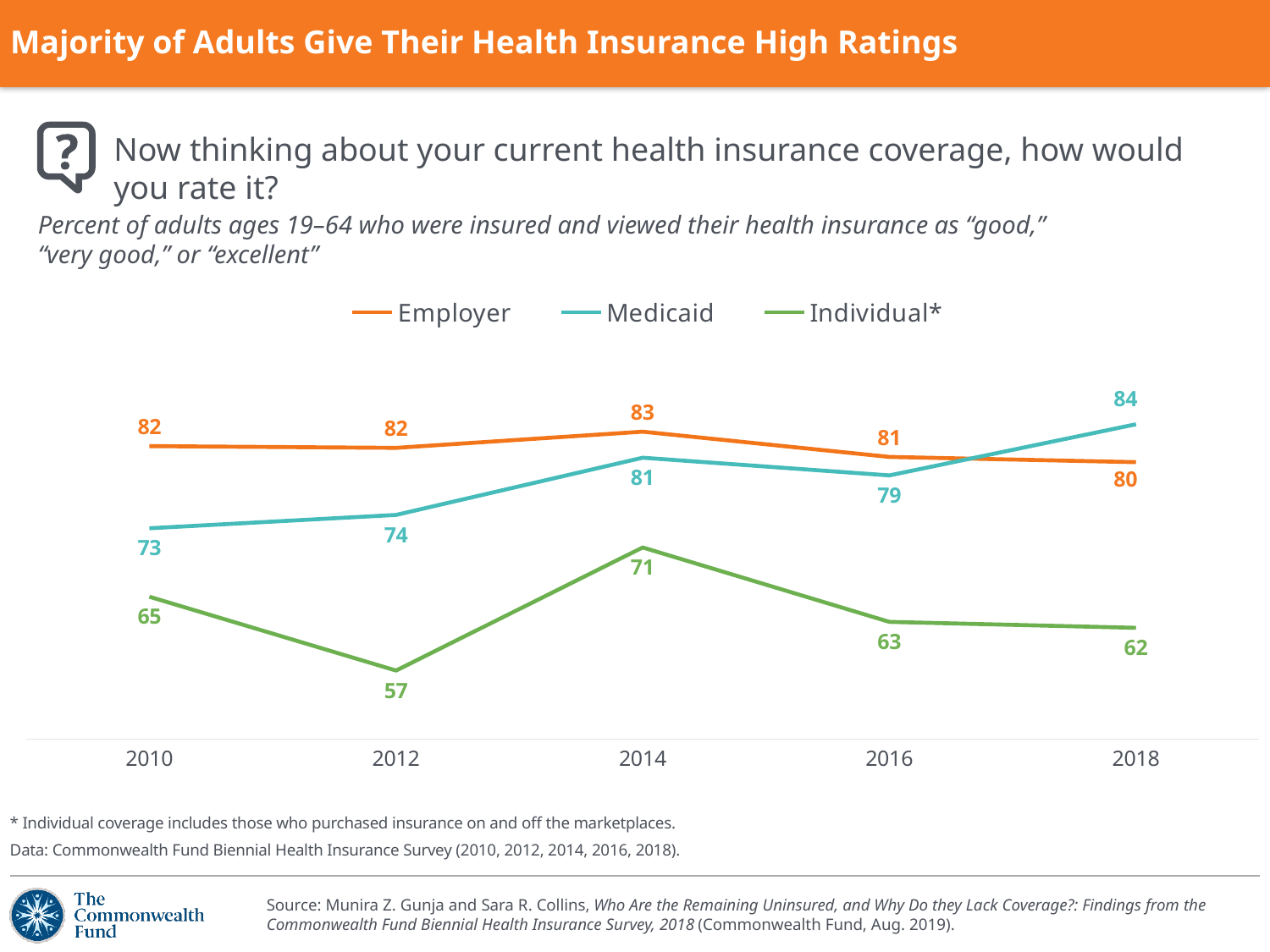
In 2018, which is larger: the Medicaid value or the Employer value? Medicaid What kind of chart is shown? Line chart In which year is the Individual* series lowest? 2012 What is the Employer value in 2014? 83 What is the difference between the Medicaid values in 2018 and 2016? 5 What is the Medicaid value in 2010? 73 How many series does the legend list? 3 How many years are shown on the x axis? 5 Does the Medicaid series rise or fall from 2010 to 2018? Rise What is the Individual* value in 2012? 57 What is the difference between the Employer and Individual* values in 2010? 17 In which year is the Medicaid series highest? 2018